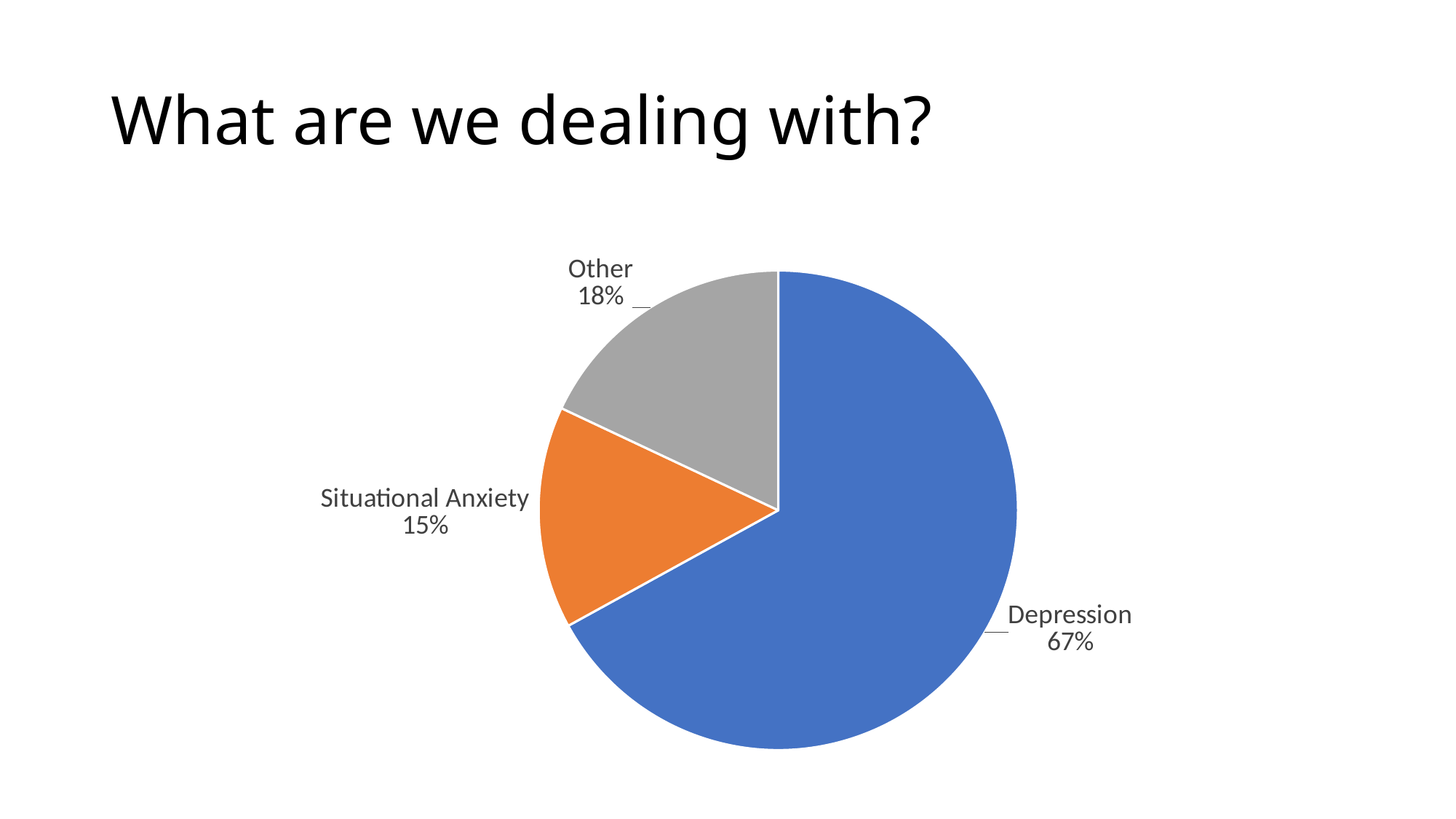
What is the value shown for Other? 18% How many categories are shown in the pie chart? 3 What colour is the Depression slice of the pie? blue What is the difference between the Depression and Other percentages? 49% What share of the pie does Depression account for? 67% Which category has the smallest slice of the pie? Situational Anxiety What is the title of the slide containing the pie chart? What are we dealing with? Which is larger, the slice for Other or the slice for Situational Anxiety? Other What kind of chart is shown on the slide? pie chart Which category has the largest slice of the pie? Depression What is the difference between the Other and Situational Anxiety percentages? 3% What is the value shown for Situational Anxiety? 15%